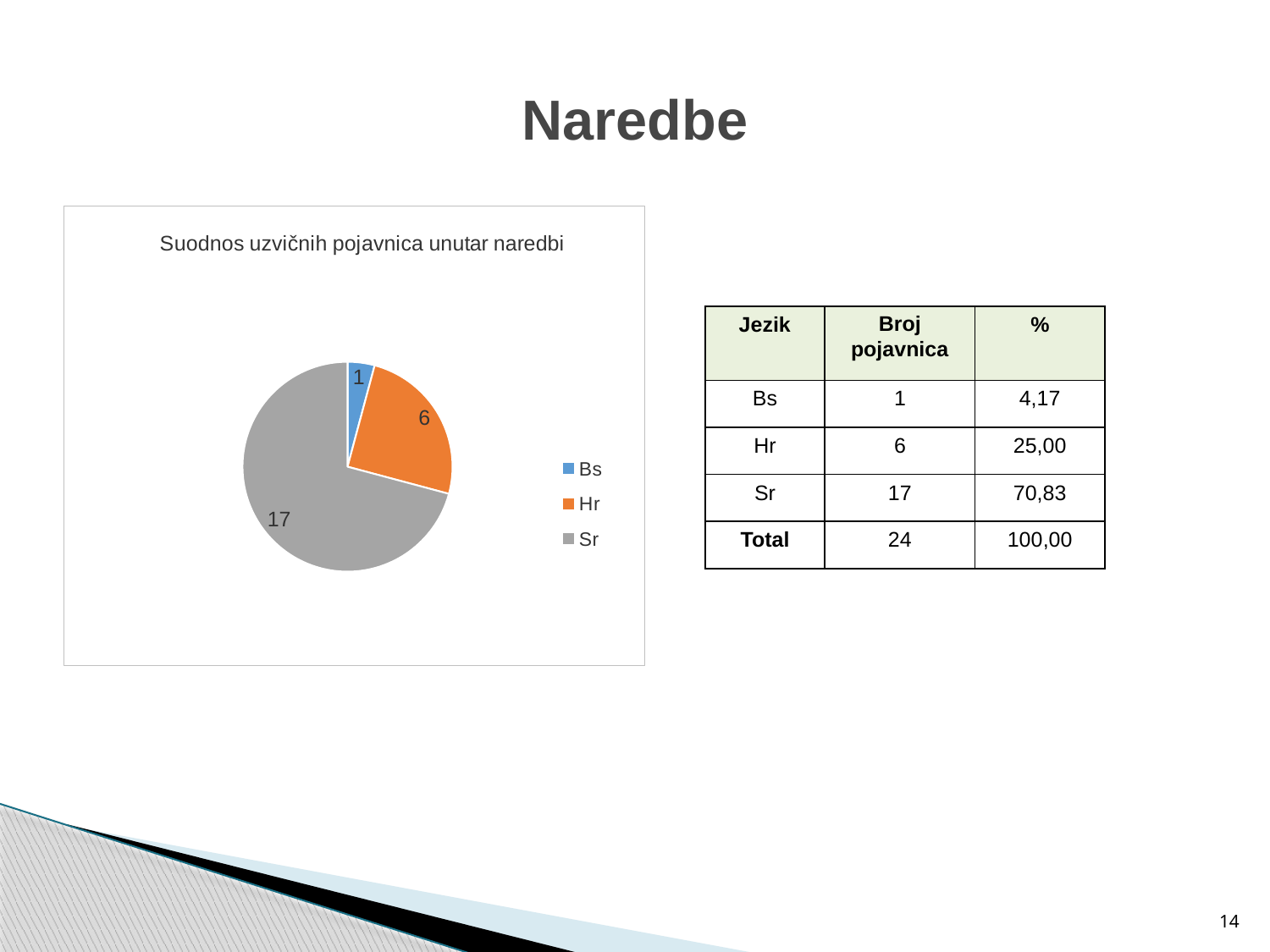
What is the chart's title? Suodnos uzvičnih pojavnica unutar naredbi Which category has the largest slice in the pie chart? Sr What is the value for Hr in the pie chart? 6 What type of chart is shown on the slide? pie chart Which is larger, the value for Hr or the value for Bs? Hr What share of the pie does Hr represent? 25,00 What is the total of all slices in the pie chart? 24 What is the difference between the values for Sr and Hr? 11 What is the value for Sr in the pie chart? 17 Which category has the smallest slice in the pie chart? Bs How many categories does the pie chart show? 3 What is the value for Bs in the pie chart? 1